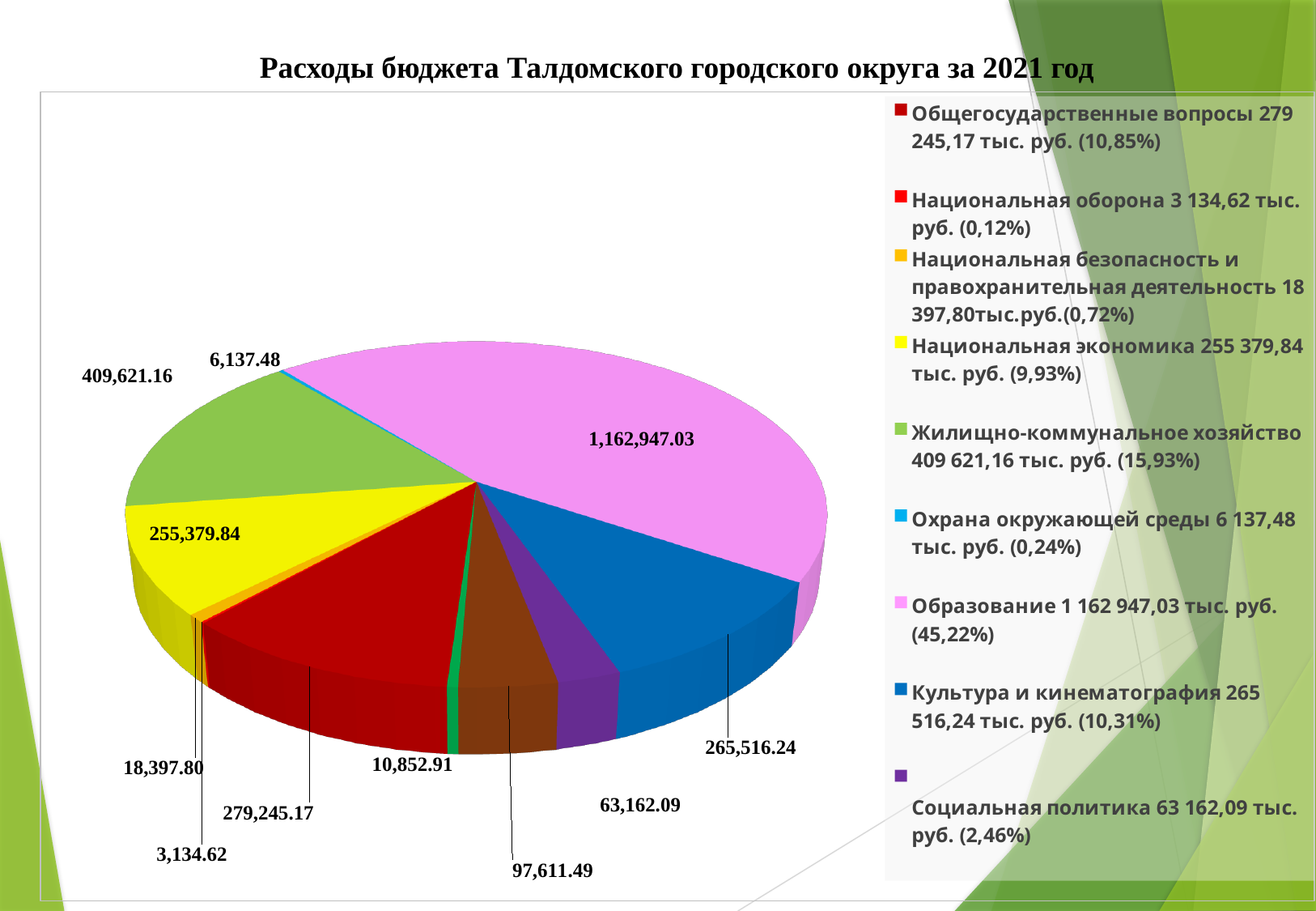
How many data labels are shown around the pie? 11 What value is labelled on the slice for Социальная политика? 63,162.09 What kind of chart is shown on the slide? Pie chart What share of the pie does Национальная экономика account for, according to the legend? 9,93% What value is labelled on the slice for Жилищно-коммунальное хозяйство? 409,621.16 What value is labelled on the slice for Культура и кинематография? 265,516.24 How many entries does the legend list? 9 Which category has the largest slice of the pie? Образование Which is larger: Общегосударственные вопросы or Национальная экономика? Общегосударственные вопросы What is the difference between the values for Жилищно-коммунальное хозяйство and Национальная экономика? 154,241.32 Which category has the smallest slice of the pie? Национальная оборона What share of the pie does Образование account for, according to the legend? 45,22%